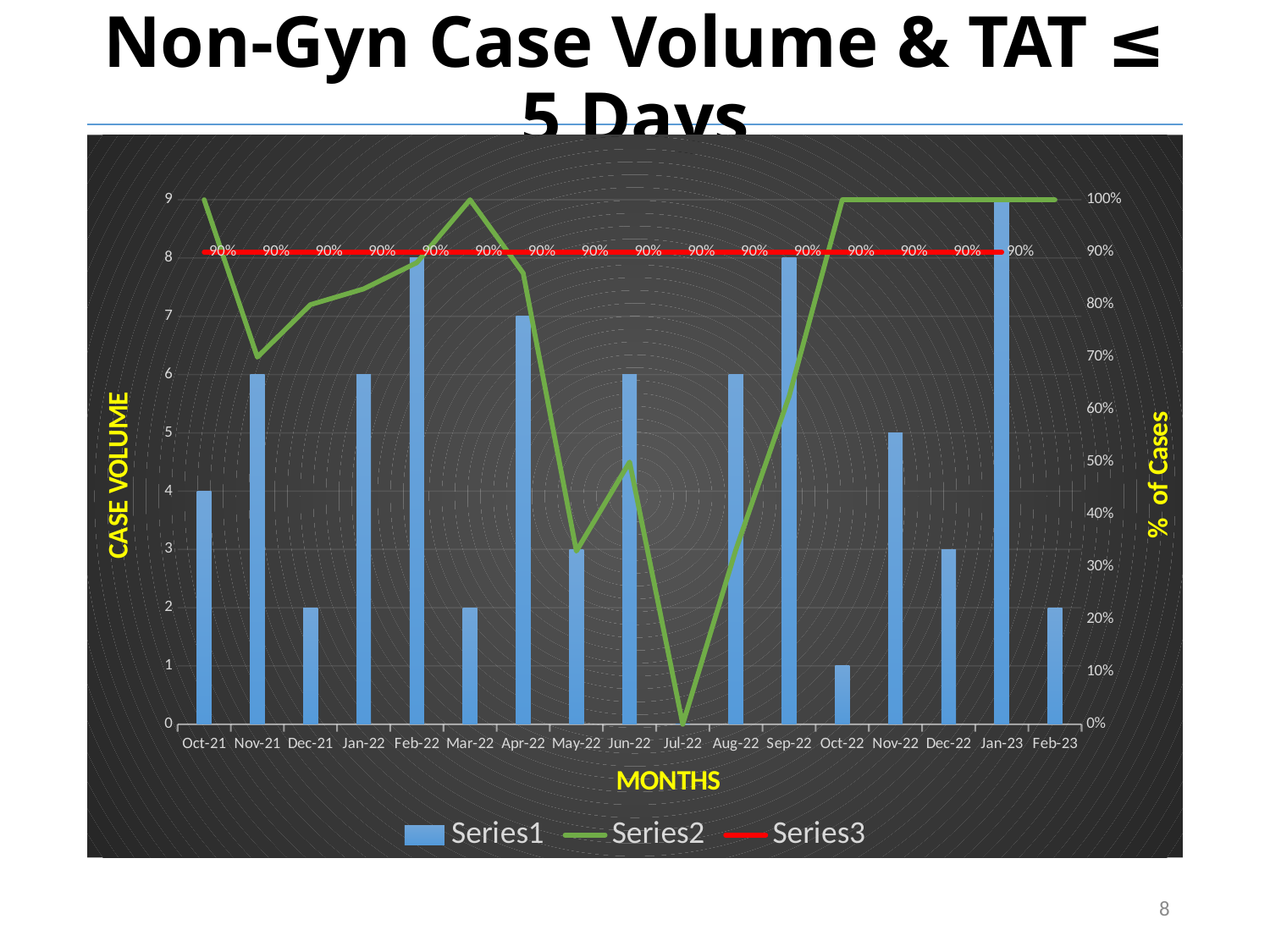
What kind of chart is this? Combination bar and line chart How many series does the legend list? 3 How many months are shown on the x axis? 17 What is the difference in case volume between Feb-22 and Mar-22? 6 What is the title of the x axis? MONTHS What value does the red Series3 line show for each month? 90% Is the Series2 value for Nov-21 greater or less than 80%? less Which month has the larger case volume, Nov-22 or Dec-22? Nov-22 What is the case volume (Series1) for Oct-22? 1 What is the case volume (Series1) for Jan-23? 9 Which month has the highest case volume (Series1)? Jan-23 What is the Series2 value for Jul-22? 0%